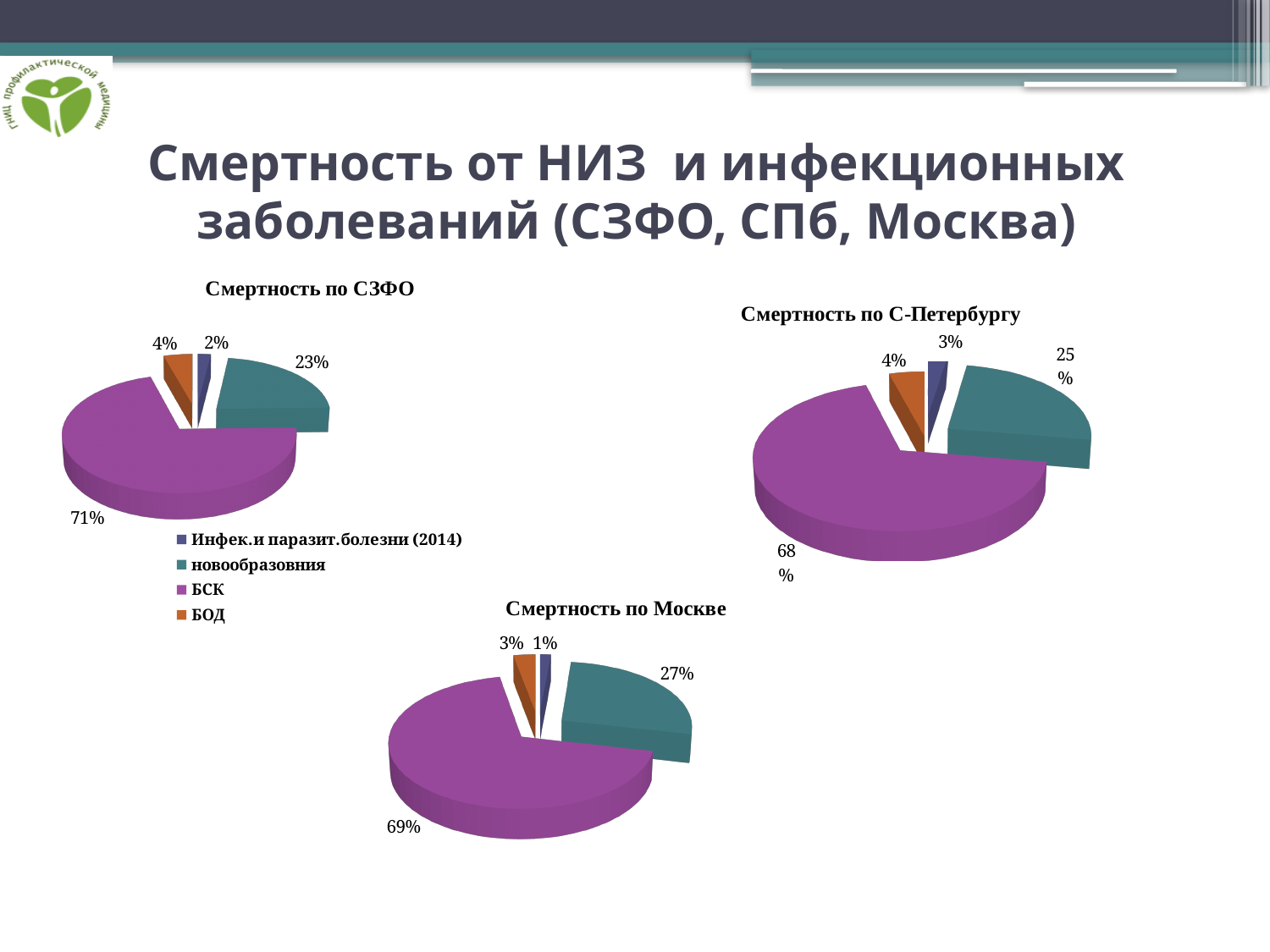
In the "Смертность по Москве" chart, what share does the magenta slice (БСК) have? 69% How many slices does the "Смертность по СЗФО" pie chart have? 4 How many entries does the legend of the "Смертность по СЗФО" chart list? 4 What kind of chart is "Смертность по СЗФО"? pie chart In the "Смертность по Москве" chart, what is the share of the smallest slice? 1% In the "Смертность по СЗФО" chart, what share does новообразовния have? 23% In the "Смертность по С-Петербургу" chart, what share does the teal slice (новообразовния) have? 25% In the "Смертность по СЗФО" chart, which category has the smallest share? Инфек.и паразит.болезни (2014) In the "Смертность по С-Петербургу" chart, what is the share of the largest slice? 68% In the "Смертность по Москве" chart, what is the difference between the БСК share and the новообразовния share? 42% In the "Смертность по СЗФО" chart, what share does БСК have? 71% Which is larger: the новообразовния share in "Смертность по Москве" or in "Смертность по СЗФО"? Смертность по Москве